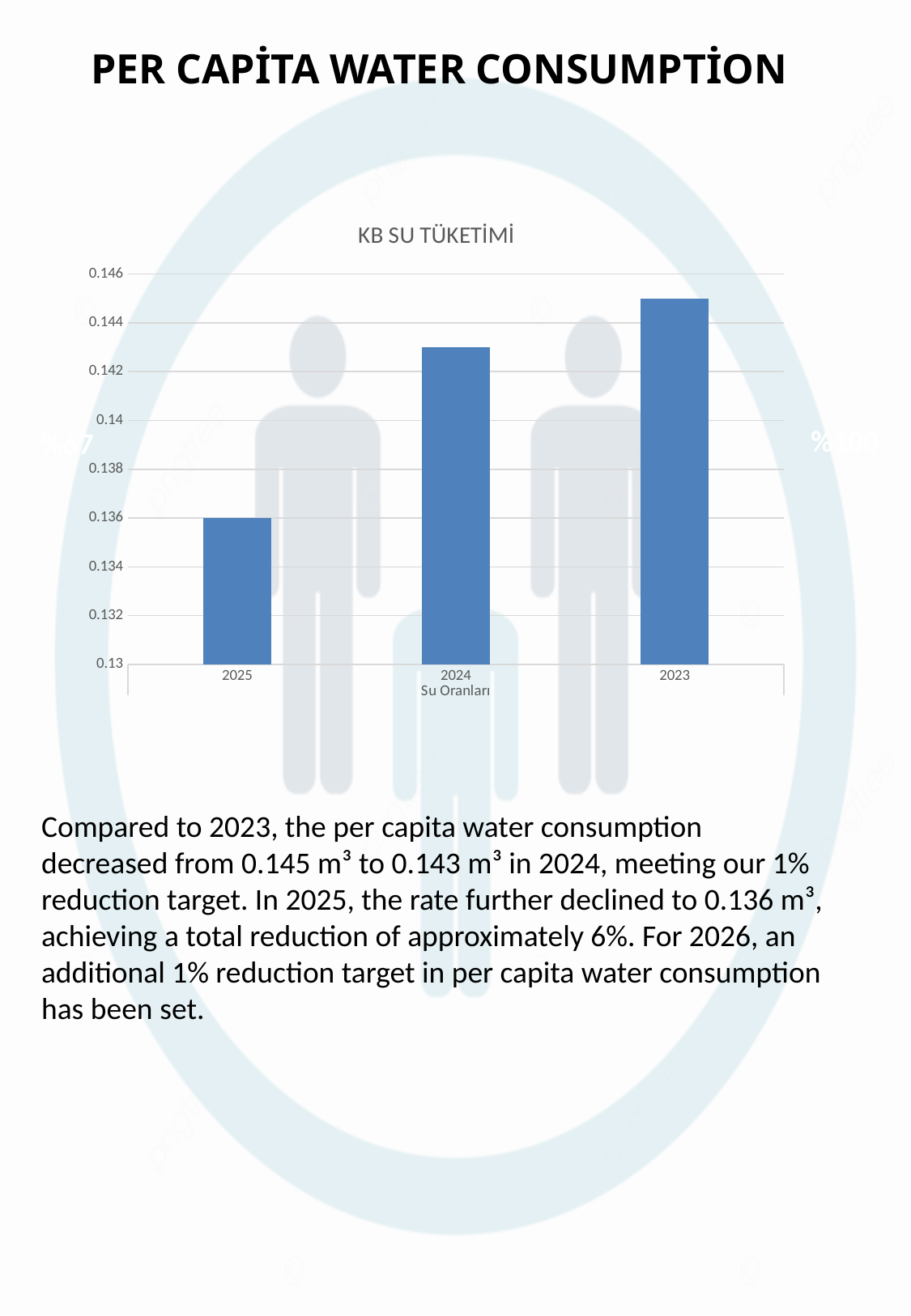
Is the value for 2024 greater or less than 0.142? greater Which is larger, the value for 2025 or the value for 2024? 2024 What type of chart is shown on the slide? bar chart What is the value for 2024 in the chart? 0.143 How many bars (years) are shown in the chart? 3 What is the value for 2023 in the chart? 0.145 Which year has the highest per capita water consumption in the chart? 2023 Is the value for 2023 greater or less than 0.144? greater What is the title of the chart? KB SU TÜKETİMİ What is the difference between the values for 2023 and 2025? 0.009 What is the value for 2025 in the chart? 0.136 Which year has the lowest per capita water consumption in the chart? 2025